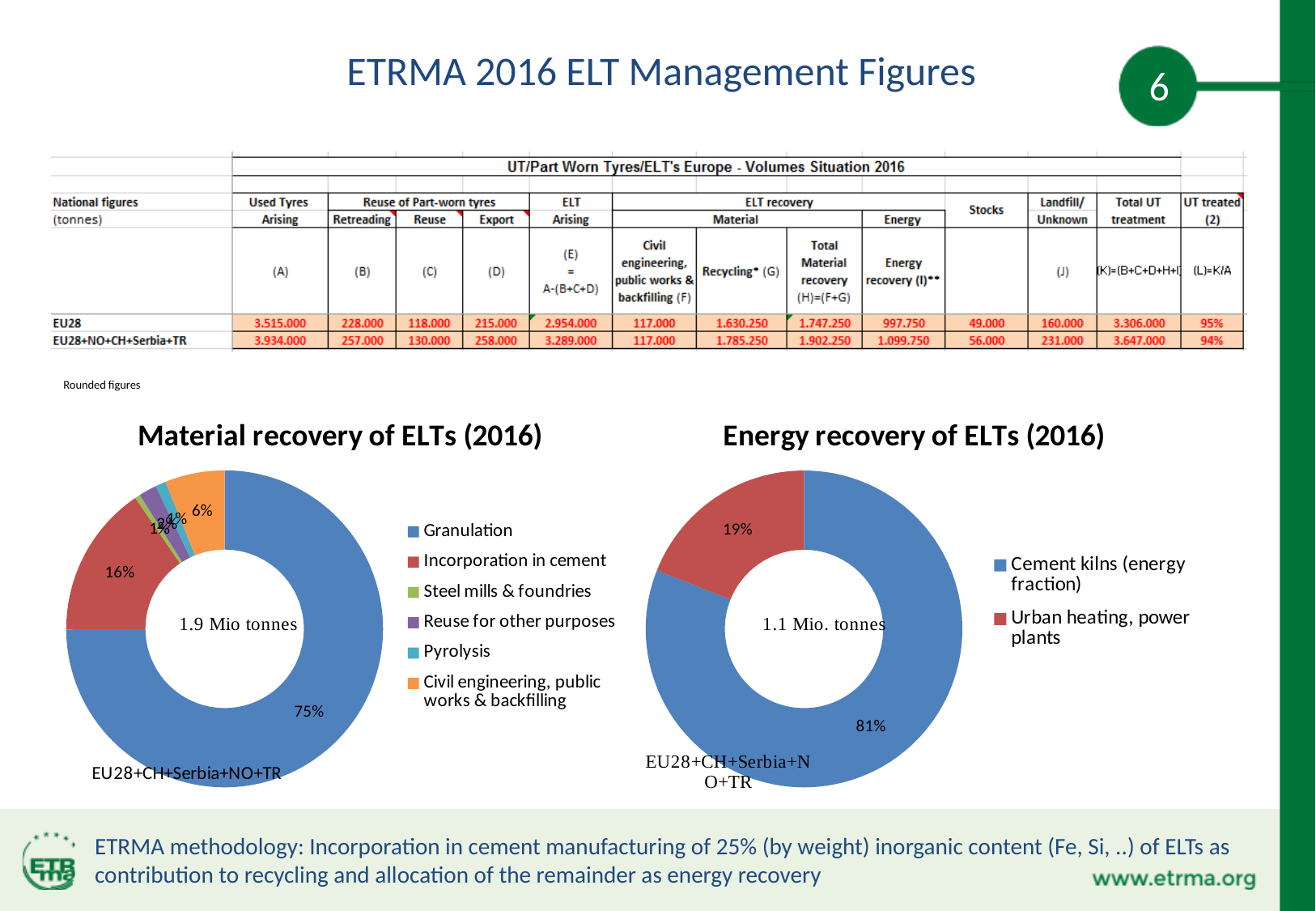
In the 'Energy recovery of ELTs (2016)' chart, what share does Cement kilns (energy fraction) have? 81% In the 'Material recovery of ELTs (2016)' chart, how many categories does the legend list? 6 In the 'Material recovery of ELTs (2016)' chart, what share does Granulation have? 75% In the 'Energy recovery of ELTs (2016)' chart, which category has the smaller share? Urban heating, power plants In the 'Material recovery of ELTs (2016)' chart, what total volume is shown in the centre of the doughnut? 1.9 Mio tonnes In the 'Material recovery of ELTs (2016)' chart, what share does Incorporation in cement have? 16% In the 'Material recovery of ELTs (2016)' chart, which category has the largest share? Granulation In the 'Energy recovery of ELTs (2016)' chart, what share does Urban heating, power plants have? 19% In the 'Material recovery of ELTs (2016)' chart, what is the difference between the Granulation share and the Incorporation in cement share? 59% In the 'Energy recovery of ELTs (2016)' chart, how many categories does the legend list? 2 What type of chart is the 'Energy recovery of ELTs (2016)' chart? Doughnut (pie) chart In the 'Material recovery of ELTs (2016)' chart, what share does Civil engineering, public works & backfilling have? 6%